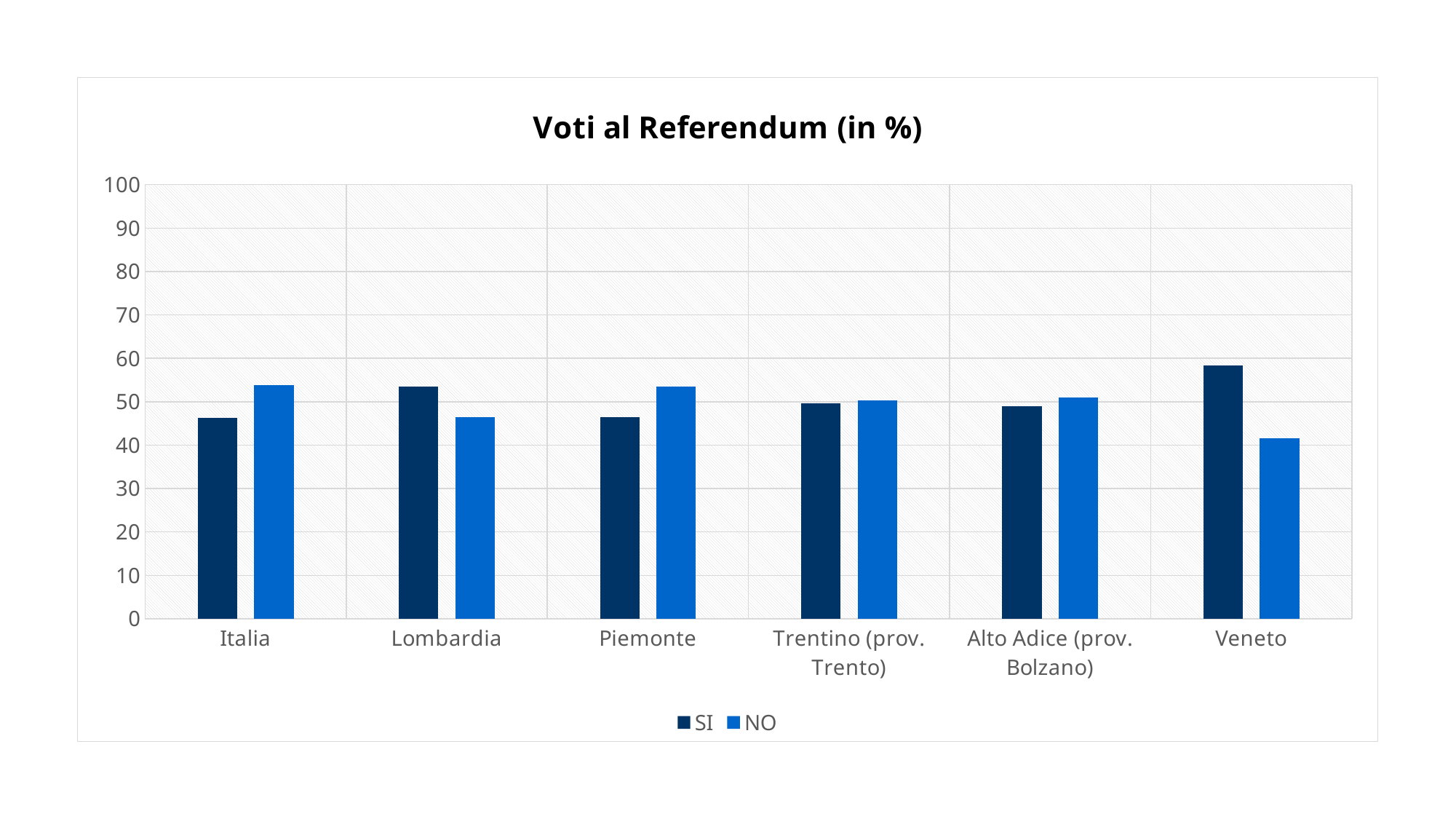
Is the SI value for Veneto greater or less than 50? greater For Piemonte, which is larger, the SI value or the NO value? NO Which category has the highest SI value? Veneto What is the title of the chart? Voti al Referendum (in %) How many categories are shown on the x axis? 6 Is the NO value for Italia greater or less than 50? greater Which category has the lowest NO value? Veneto What kind of chart is shown on the slide? bar chart Is the SI value for Italia greater or less than 50? less How many series does the legend list? 2 For Lombardia, which is larger, the SI value or the NO value? SI